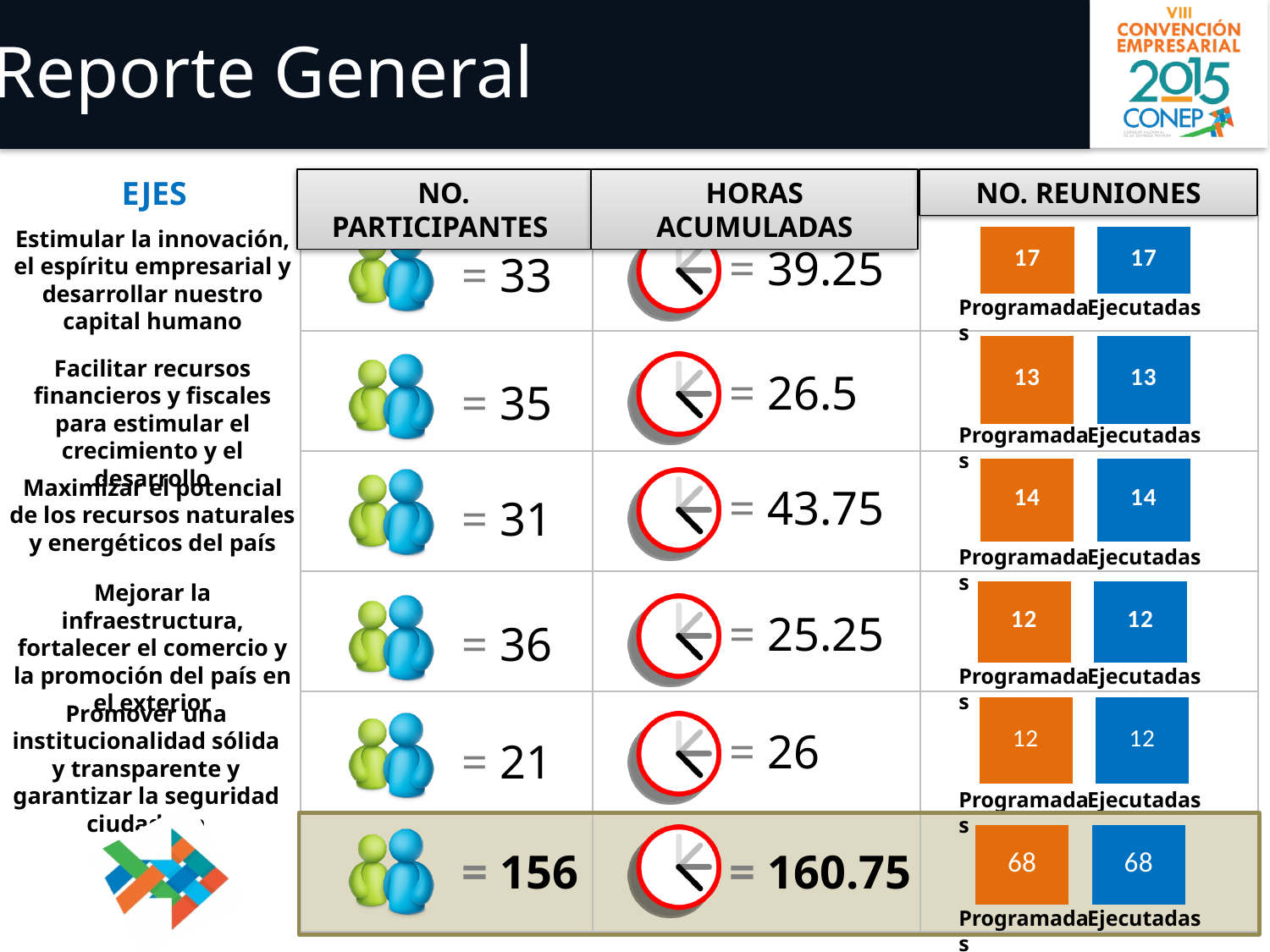
In the NO. REUNIONES chart for the third row (Maximizar el potencial de los recursos naturales), what is the value for Ejecutadas? 14 In the NO. REUNIONES chart for the fourth row (Mejorar la infraestructura), what is the value for Programadas? 12 In the NO. REUNIONES chart for the second row (Facilitar recursos financieros y fiscales), what is the value for Programadas? 13 In the NO. REUNIONES chart in the bottom total row, what is the value for Programadas? 68 In the NO. REUNIONES charts, what colour is the Programadas bar? Orange What kind of chart is used in the NO. REUNIONES column? Bar chart How many bars does the NO. REUNIONES chart in the first row contain? 2 In the NO. REUNIONES charts, what colour is the Ejecutadas bar? Blue In the NO. REUNIONES chart for the first row (Estimular la innovación), what is the value for Ejecutadas? 17 In the NO. REUNIONES chart for the first row (Estimular la innovación), what is the value for Programadas? 17 In the NO. REUNIONES chart for the fifth row (Promover una institucionalidad sólida), what is the value for Ejecutadas? 12 In the NO. REUNIONES chart in the bottom total row, what is the difference between Programadas and Ejecutadas? 0